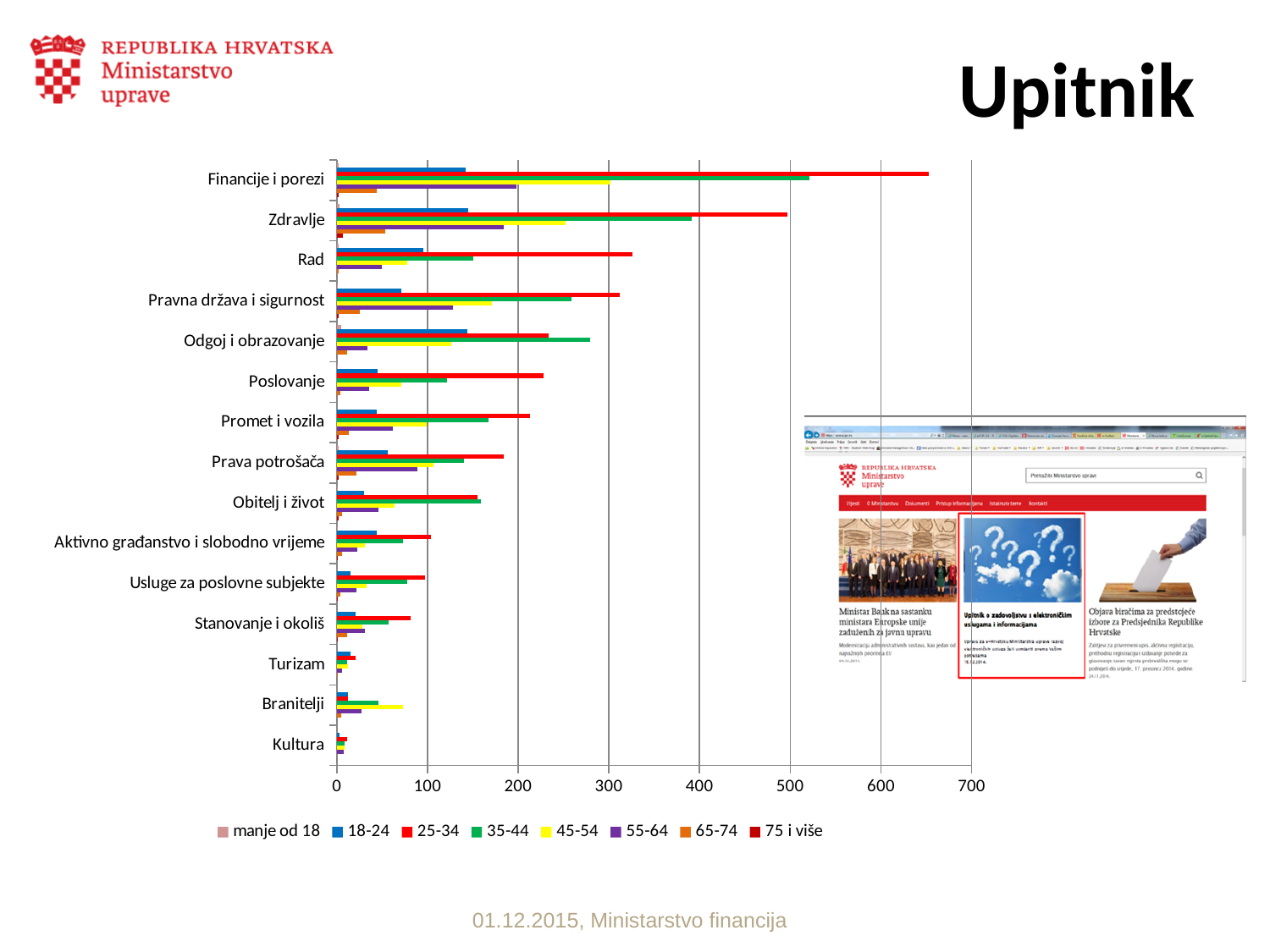
Which category has the shortest bars overall in the chart? Kultura Is the value for the 25-34 series in Rad greater or less than 300? greater How many categories are listed on the vertical axis of the chart? 15 Which series is shown in yellow in the chart legend? 45-54 Which category has the longest bar for the 25-34 series? Financije i porezi For Odgoj i obrazovanje, which series has the larger value: 35-44 or 25-34? 35-44 What kind of chart is shown on the slide? bar chart Is the value for the 25-34 series in Prava potrošača greater or less than 200? less For the 25-34 series, which category has the larger value: Financije i porezi or Zdravlje? Financije i porezi How many series does the chart legend list? 8 Is the value for the 25-34 series in Financije i porezi greater or less than 600? greater